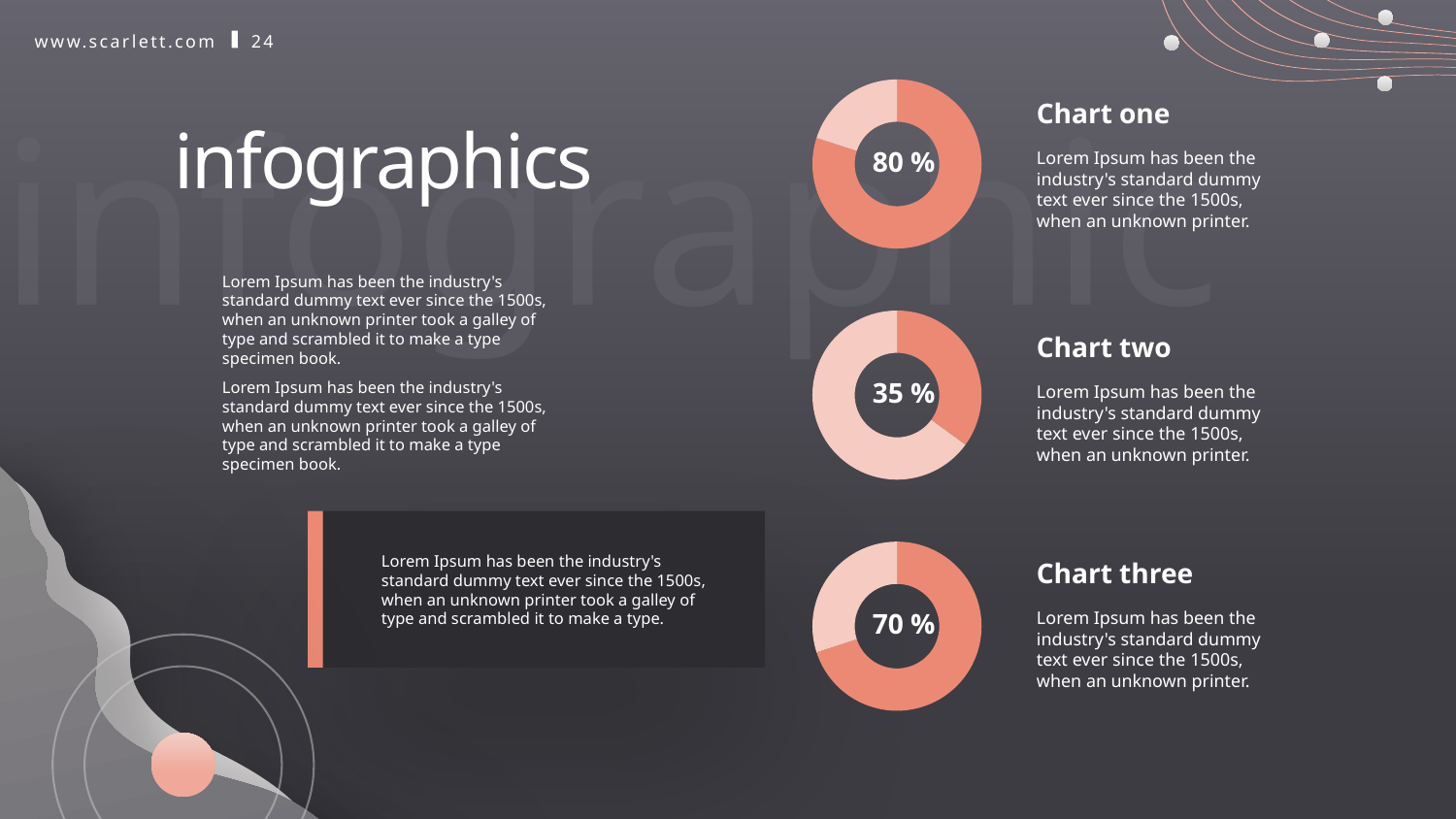
What kind of chart is used for Chart one, Chart two and Chart three? Donut (pie) chart What value is shown in the centre of Chart two? 35 % What is the difference between the percentage in Chart one and the percentage in Chart two? 45 % What is the difference between the percentage in Chart three and the percentage in Chart two? 35 % Which shows a larger percentage, Chart one or Chart three? Chart one In Chart two, what share of the ring is not covered by the 35 % segment? 65 % What value is shown in the centre of Chart three? 70 % Which of the three charts (Chart one, Chart two, Chart three) shows the highest percentage? Chart one How many donut charts are shown on the slide? 3 What value is shown in the centre of Chart one? 80 % Which of the three charts (Chart one, Chart two, Chart three) shows the lowest percentage? Chart two How many segments does each donut chart on the slide have? 2